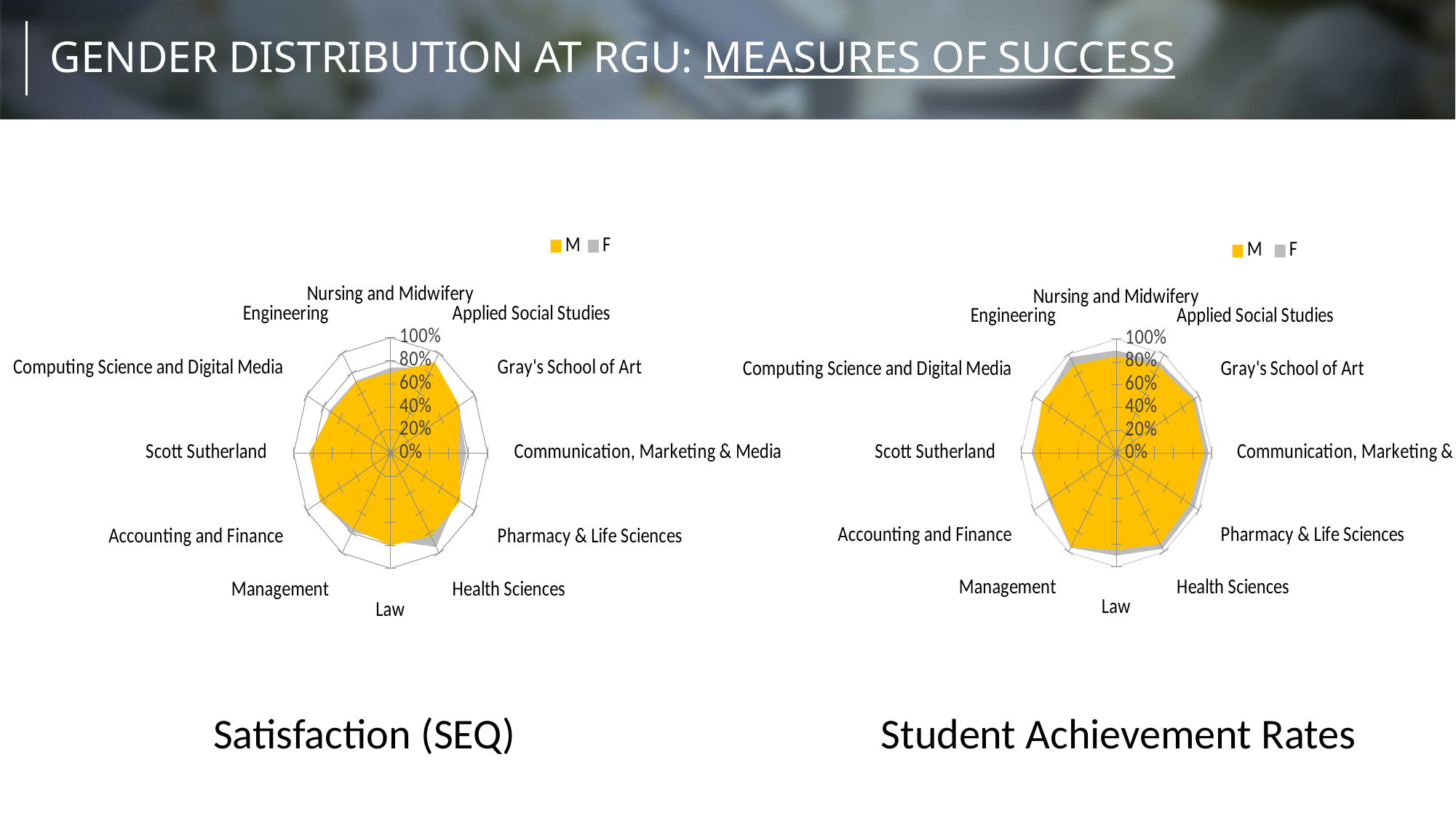
In the Satisfaction (SEQ) chart, is the M value for Computing Science and Digital Media greater or less than 40%? greater What is the maximum value shown on the axis of the Satisfaction (SEQ) chart? 100% What kind of chart is the Satisfaction (SEQ) chart? Radar chart How many categories (schools) are plotted on the Student Achievement Rates chart? 12 How many series does the legend of the Satisfaction (SEQ) chart list? 2 In the Student Achievement Rates chart, is the M value for Scott Sutherland greater or less than 60%? greater In the Student Achievement Rates chart, is the M value for Law greater or less than 40%? greater What are the two legend entries on the Satisfaction (SEQ) chart? M and F How many series does the legend of the Student Achievement Rates chart list? 2 How many categories (schools) are plotted on the Satisfaction (SEQ) chart? 12 What colour represents the M series in the Student Achievement Rates chart? Yellow What kind of chart is the Student Achievement Rates chart? Radar chart